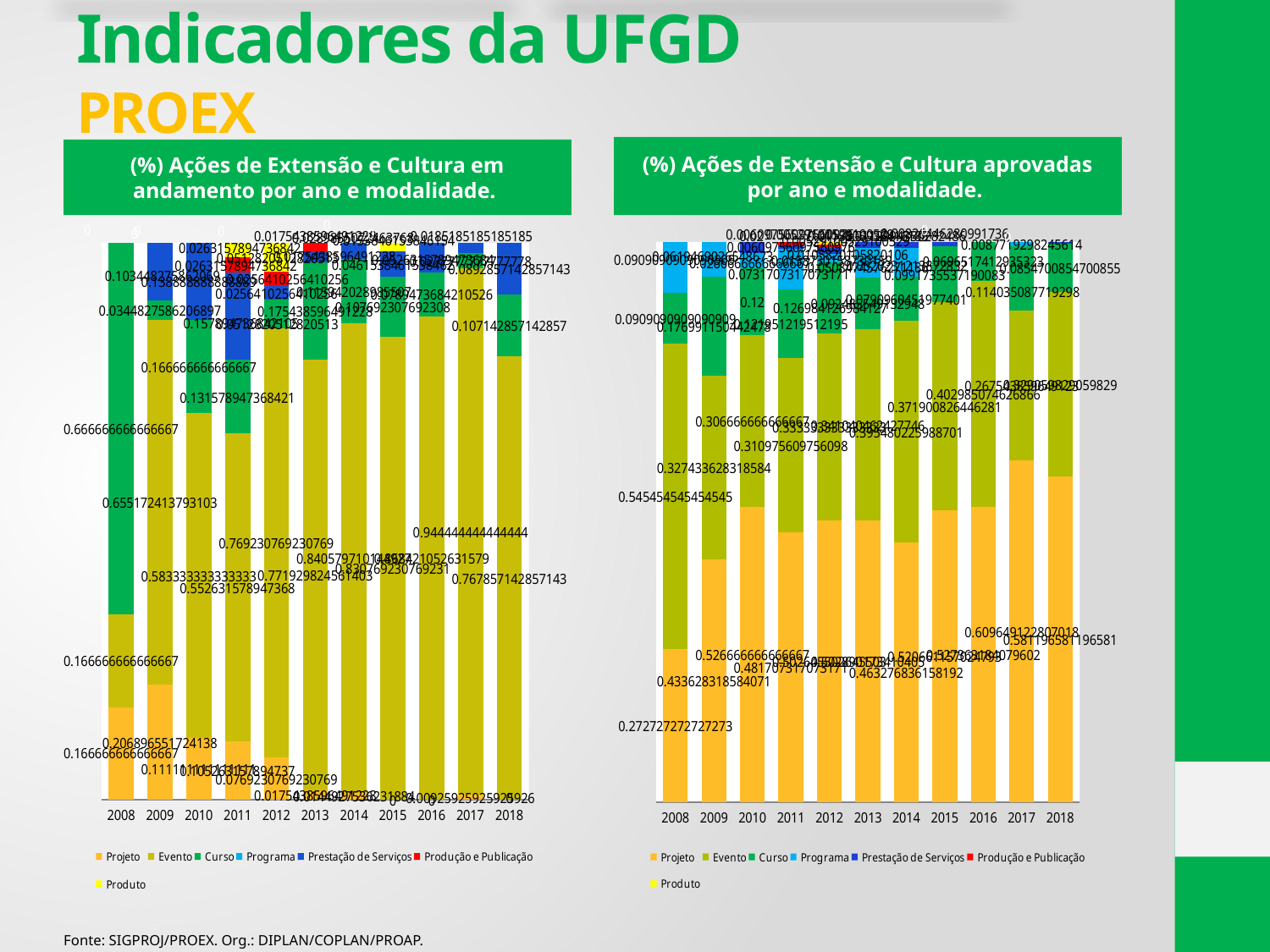
In the right chart ('aprovadas'), which is larger in 2008, Projeto or Evento? Evento What kind of chart is the left chart, '(%) Ações de Extensão e Cultura em andamento por ano e modalidade'? Stacked bar chart In the left chart ('em andamento'), which year has the highest value for Evento? 2017 In the left chart ('em andamento'), what is the value for Projeto in 2009? 0.206896551724138 How many years are shown on the x axis of the right chart, '(%) Ações de Extensão e Cultura aprovadas por ano e modalidade'? 11 In the left chart ('em andamento'), what is the value for Evento in 2017? 0.944444444444444 In the right chart ('aprovadas'), what is the value for Evento in 2008? 0.545454545454545 In the left chart ('em andamento'), what is the difference between the Curso and Projeto values in 2008? 0.5 In the right chart ('aprovadas'), what is the value for Projeto in 2017? 0.609649122807018 How many series does the legend of the left chart list? 7 In the right chart ('aprovadas'), what is the value for Projeto in 2008? 0.272727272727273 In the left chart ('em andamento'), what is the value for Curso in 2008? 0.666666666666667